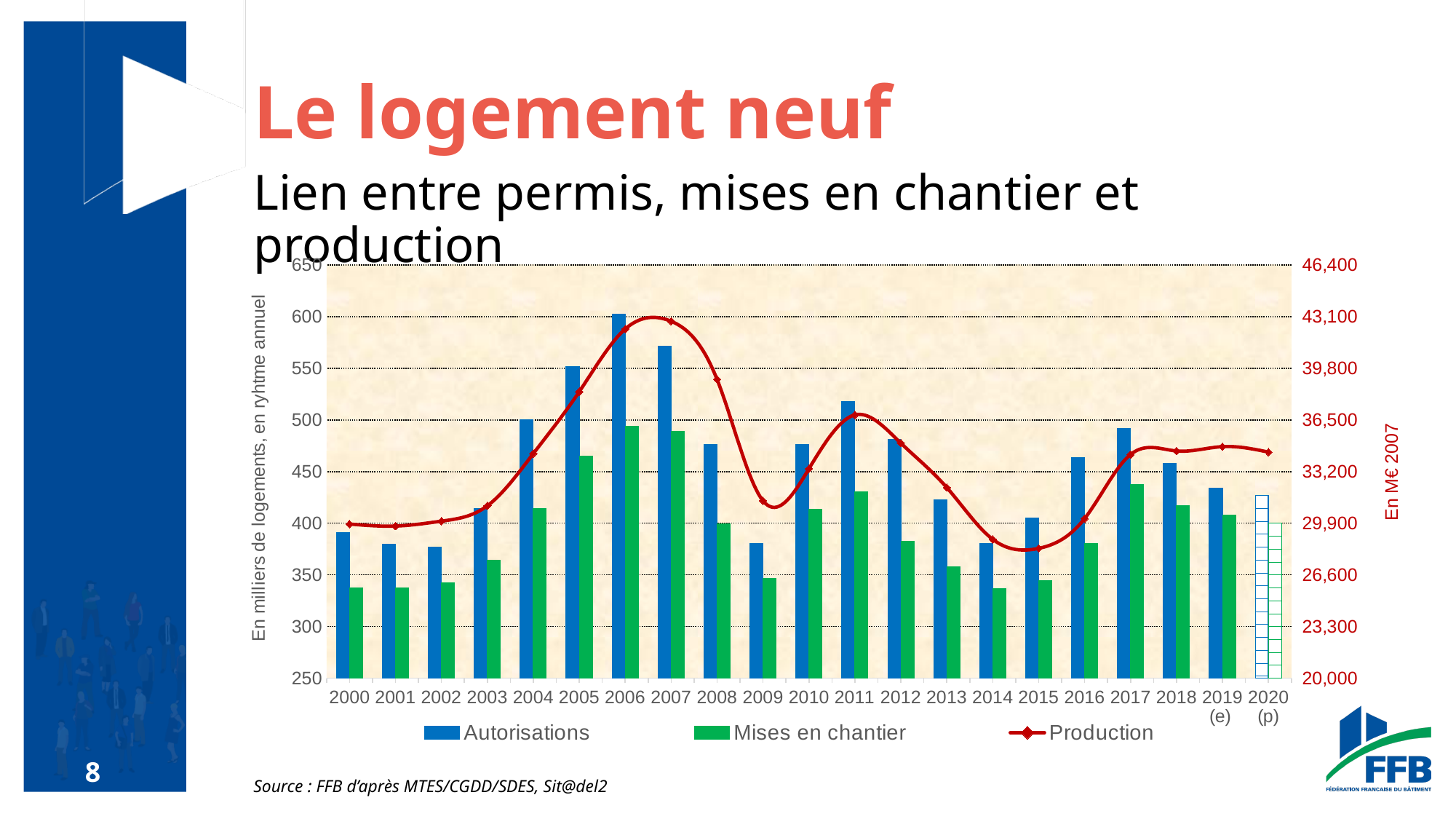
Is the Autorisations value for 2006 greater or less than 550? greater What is the label of the right-hand vertical axis? En M€ 2007 Which is larger, the Autorisations value for 2005 or for 2008? 2005 How many series does the legend list? 3 What kind of chart is shown on the slide? A combined bar and line chart In which year is the Autorisations bar the highest? 2006 What colour are the Mises en chantier bars? Green Is the Mises en chantier value for 2000 greater or less than 350? less Does the Production line rise or fall from 2009 to 2011? rise Is the Autorisations value for 2004 greater or less than 450? greater Do the Autorisations values rise or fall from 2011 to 2015? fall How many years are shown along the x axis? 21